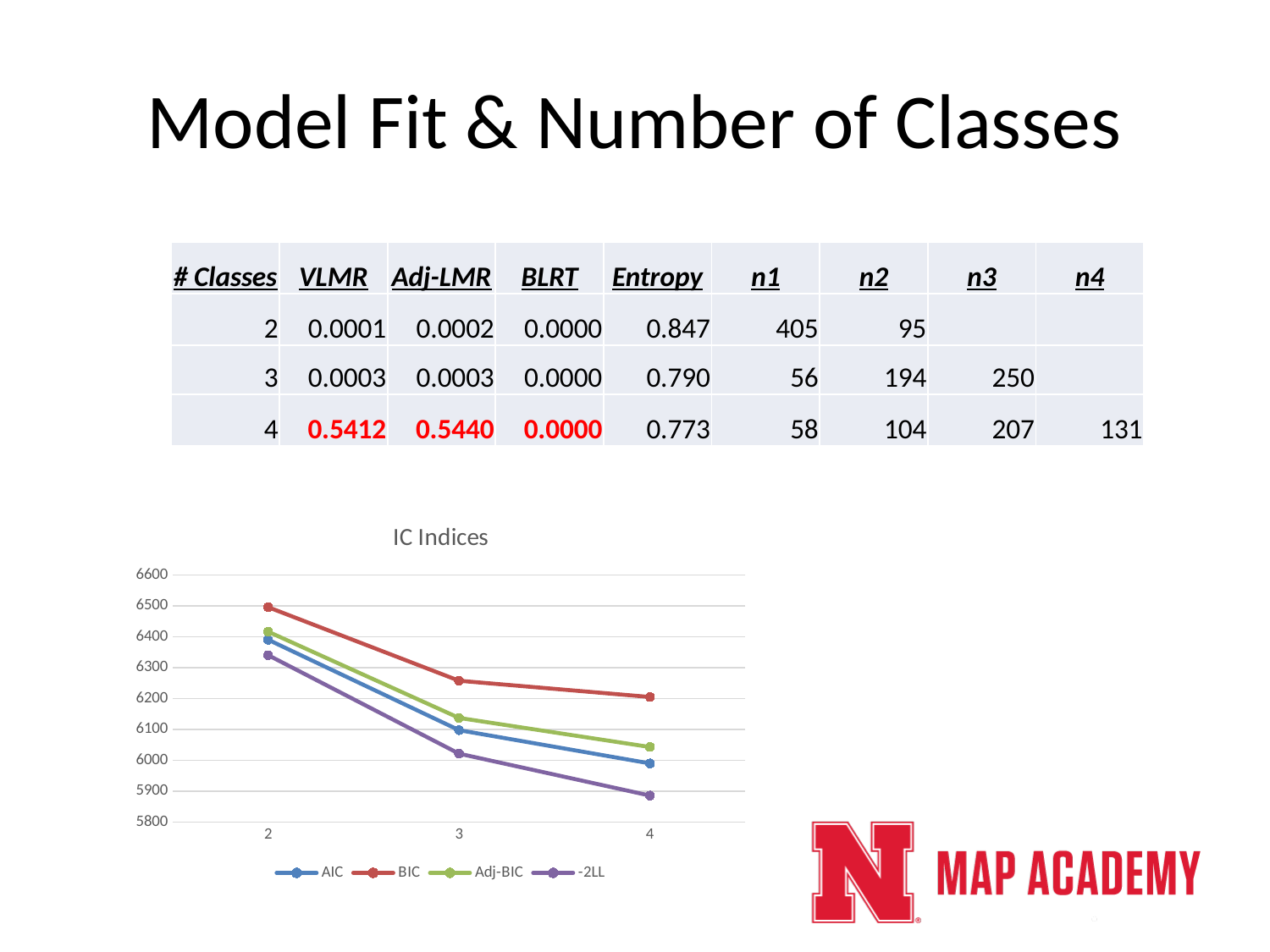
What is the title of the line chart on the slide? IC Indices In the IC Indices chart, which series has the highest value at 2 classes? BIC What kind of chart is the IC Indices chart? line chart How many points along the x axis does each series in the IC Indices chart have? 3 In the IC Indices chart, do the values rise or fall as the number of classes increases from 2 to 4? fall In the IC Indices chart, is the BIC value at 2 classes greater or less than 6400? greater How many series does the legend of the IC Indices chart list? 4 In the IC Indices chart, which series has the lowest value at 4 classes? -2LL In the IC Indices chart, is the -2LL value at 4 classes greater or less than 6000? less In the IC Indices chart, is the BIC value at 4 classes greater or less than 6100? greater In the IC Indices chart, which is larger at 3 classes, AIC or BIC? BIC